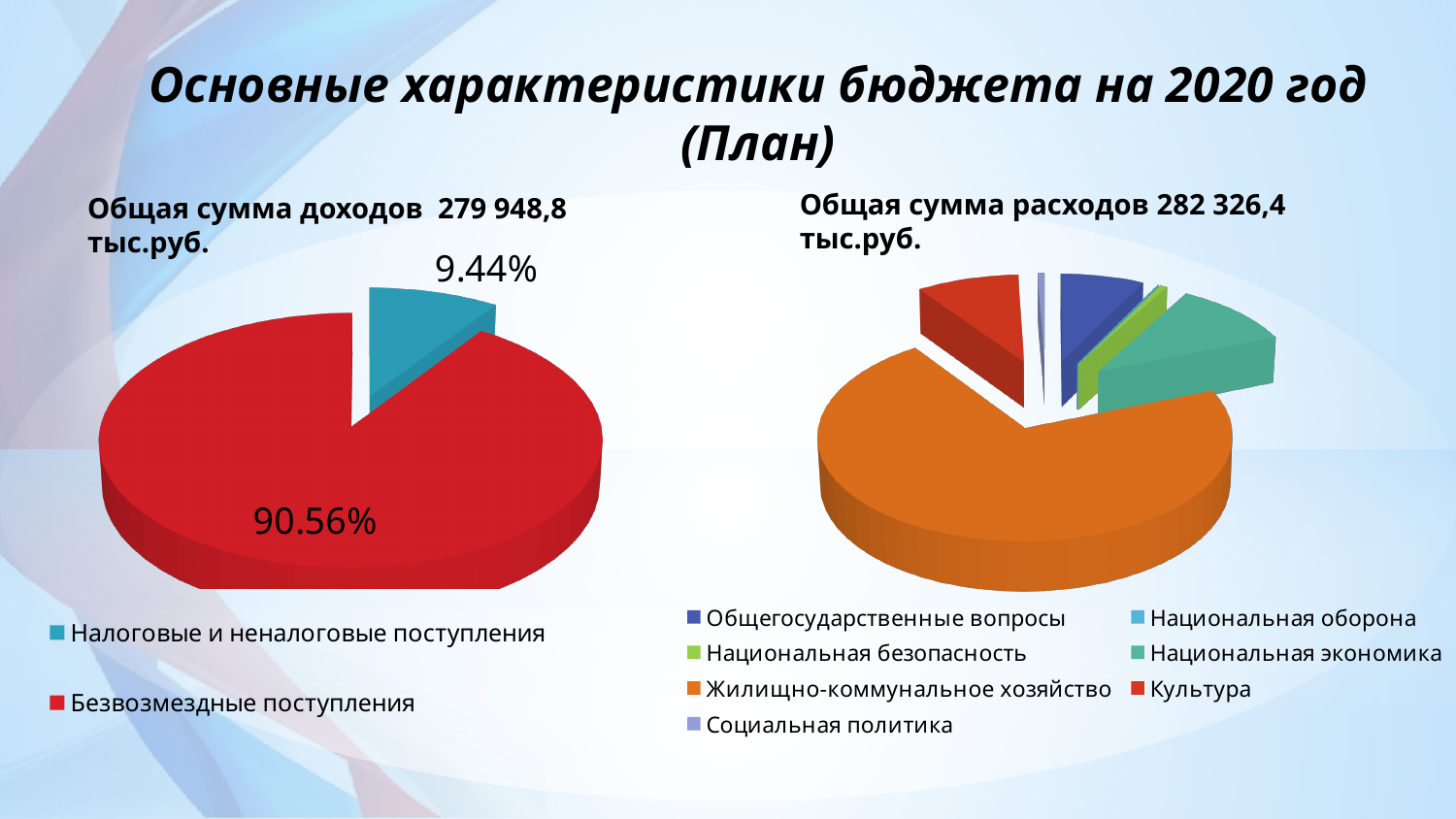
On the left chart (Общая сумма доходов), what share is shown for Безвозмездные поступления? 90.56% On the left chart (Общая сумма доходов), which category has the largest share? Безвозмездные поступления On the left chart (Общая сумма доходов), what is the difference in percentage points between Безвозмездные поступления and Налоговые и неналоговые поступления? 81.12 On the right chart (Общая сумма расходов), how many categories does the legend list? 7 What total amount of expenses is stated in the title of the right chart? 282 326,4 тыс.руб. On the left chart (Общая сумма доходов), which category has the smallest share? Налоговые и неналоговые поступления On the right chart (Общая сумма расходов), which category has the largest slice? Жилищно-коммунальное хозяйство On the left chart (Общая сумма доходов), how many categories does the legend list? 2 What type of chart is the right chart (Общая сумма расходов)? Pie chart On the right chart (Общая сумма расходов), which slice is larger: Национальная экономика or Национальная безопасность? Национальная экономика On the left chart (Общая сумма доходов), what share is shown for Налоговые и неналоговые поступления? 9.44% What type of chart is the left chart (Общая сумма доходов)? Pie chart